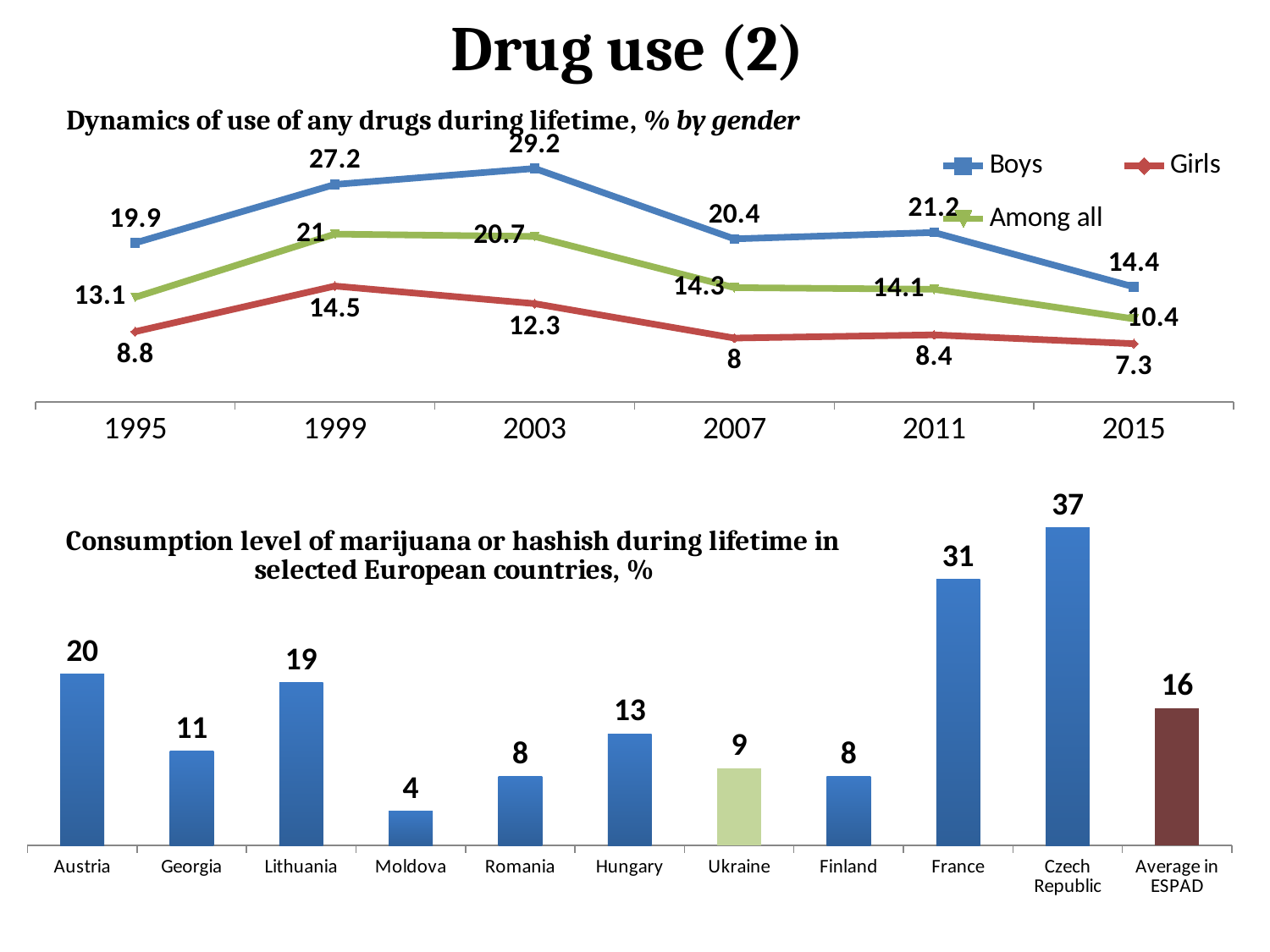
In the top chart (Dynamics of use of any drugs during lifetime), what is the value for Among all in 1999? 21 In the bottom chart (Consumption level of marijuana or hashish), which country has the lowest value? Moldova In the bottom chart (Consumption level of marijuana or hashish), what is the difference between the Czech Republic and the Average in ESPAD? 21 What type of chart is the bottom chart (Consumption level of marijuana or hashish)? Bar chart In the top chart (Dynamics of use of any drugs during lifetime), what is the difference between the Boys and Girls values in 2003? 16.9 In the top chart (Dynamics of use of any drugs during lifetime), how many series does the legend list? 3 In the top chart (Dynamics of use of any drugs during lifetime), in which year is the Boys value highest? 2003 In the bottom chart (Consumption level of marijuana or hashish), which country has the highest value? Czech Republic In the top chart (Dynamics of use of any drugs during lifetime), what is the value for Boys in 2003? 29.2 In the bottom chart (Consumption level of marijuana or hashish), what is the value for Ukraine? 9 In the top chart (Dynamics of use of any drugs during lifetime), what is the value for Girls in 2015? 7.3 In the top chart (Dynamics of use of any drugs during lifetime), how does the Girls value change from 2011 to 2015? It falls